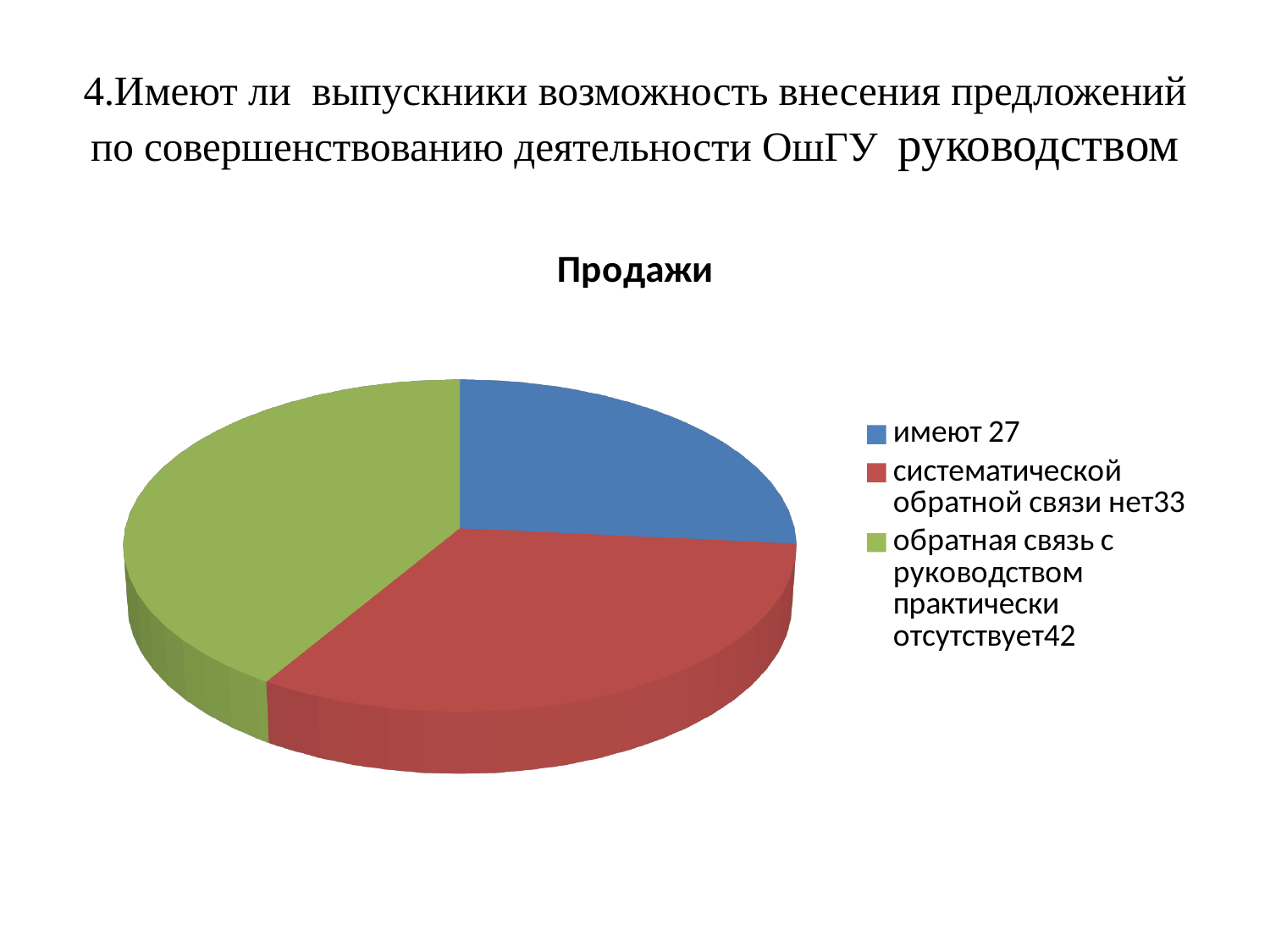
What is the title of the chart? Продажи Which category has the largest slice of the pie? обратная связь с руководством практически отсутствует What kind of chart is shown on the slide? pie chart How many entries does the legend list? 3 What number is given in the legend for "обратная связь с руководством практически отсутствует"? 42 What is the difference between the value for "обратная связь с руководством практически отсутствует" and the value for "имеют"? 15 Which is larger: the slice for "имеют" or the slice for "систематической обратной связи нет"? систематической обратной связи нет Which category has the smallest slice of the pie? имеют What colour is the slice for "имеют"? blue What number is given in the legend for "систематической обратной связи нет"? 33 How many slices does the pie chart have? 3 What number is given in the legend for the category "имеют"? 27